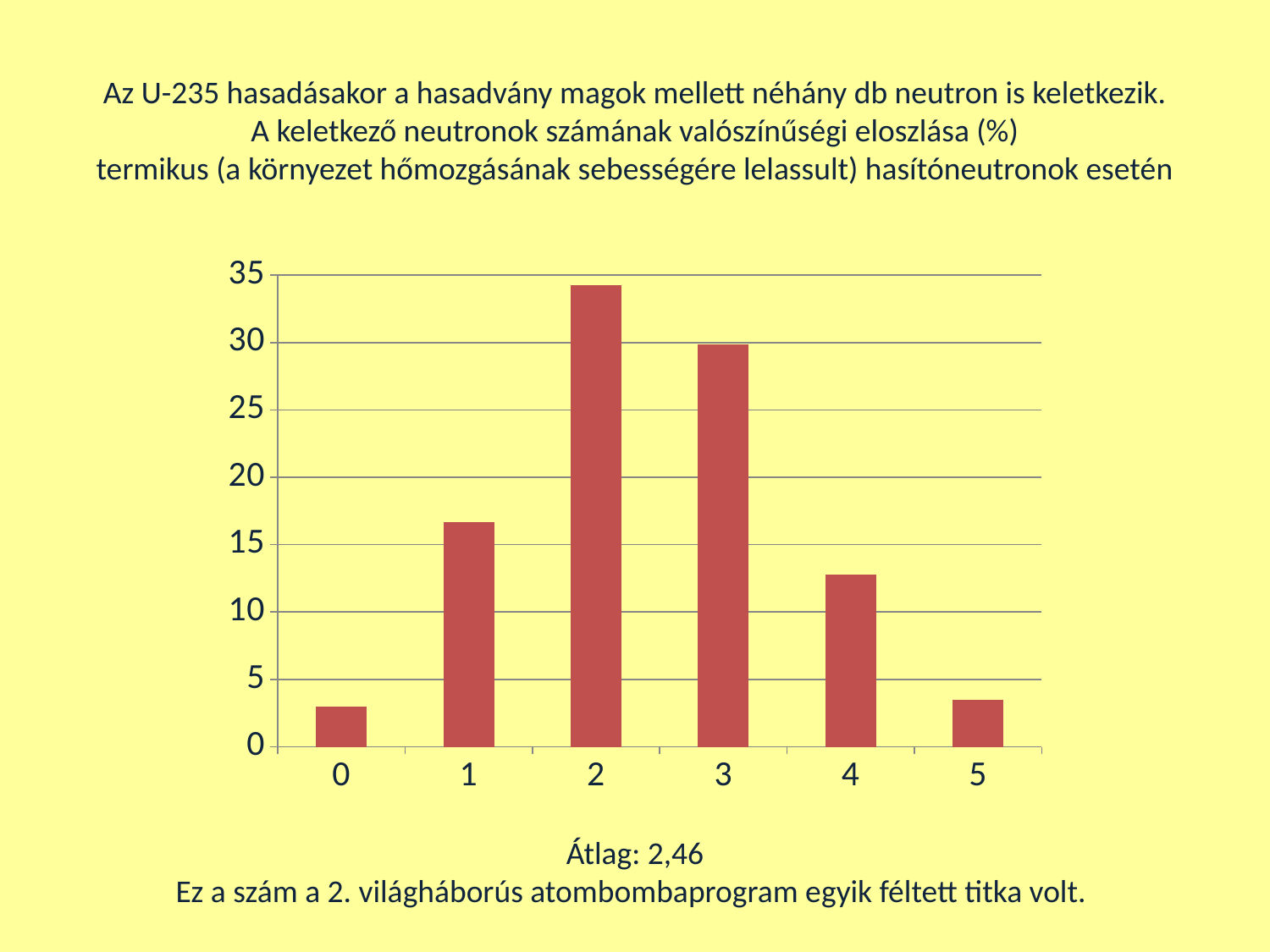
What average (Átlag) value is stated below the chart? 2,46 How many categories are shown on the x axis of the chart? 6 Which category has the highest bar in the chart? 2 Is the value for category 1 greater or less than 15? greater Is the value for category 3 greater or less than 25? greater Is the value for category 0 greater or less than 5? less Which has the larger value, category 1 or category 4? 1 Do the values rise or fall from category 2 to category 5? fall What kind of chart is shown on the slide? bar chart Which has the larger value, category 2 or category 3? 2